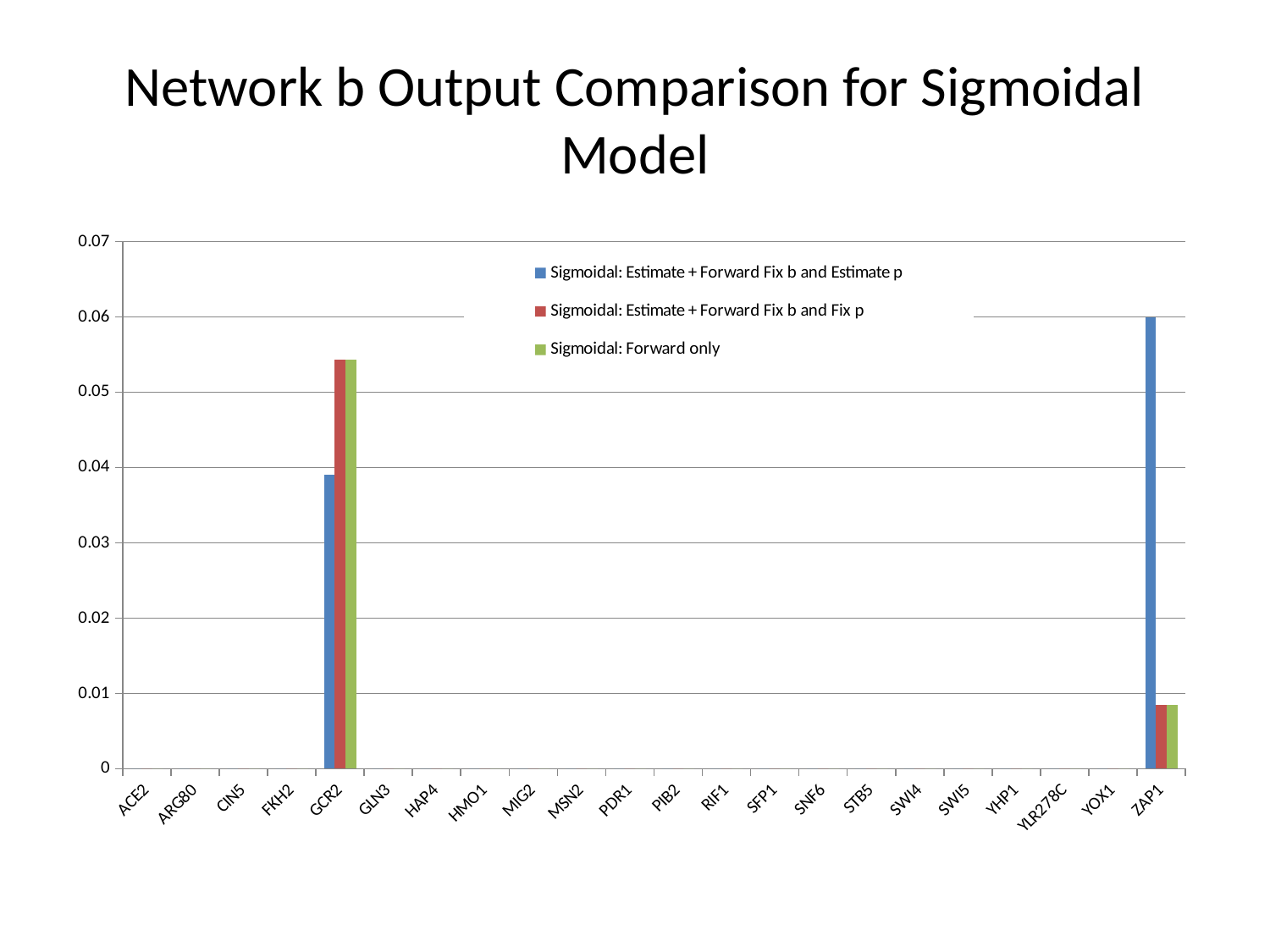
Which category has the highest value for the 'Sigmoidal: Forward only' series? GCR2 What colour represents the 'Sigmoidal: Forward only' series? green For GCR2, which series has the larger value: 'Sigmoidal: Estimate + Forward Fix b and Estimate p' or 'Sigmoidal: Estimate + Forward Fix b and Fix p'? Sigmoidal: Estimate + Forward Fix b and Fix p Which category has the highest value for the 'Sigmoidal: Estimate + Forward Fix b and Estimate p' series? ZAP1 What is the title of the slide? Network b Output Comparison for Sigmoidal Model What kind of chart is shown on the slide? bar chart How many series does the legend list? 3 How many categories are shown along the x axis? 22 Is the value for GCR2 in the 'Sigmoidal: Forward only' series greater or less than 0.05? greater For ZAP1, which series has the larger value: 'Sigmoidal: Estimate + Forward Fix b and Estimate p' or 'Sigmoidal: Forward only'? Sigmoidal: Estimate + Forward Fix b and Estimate p